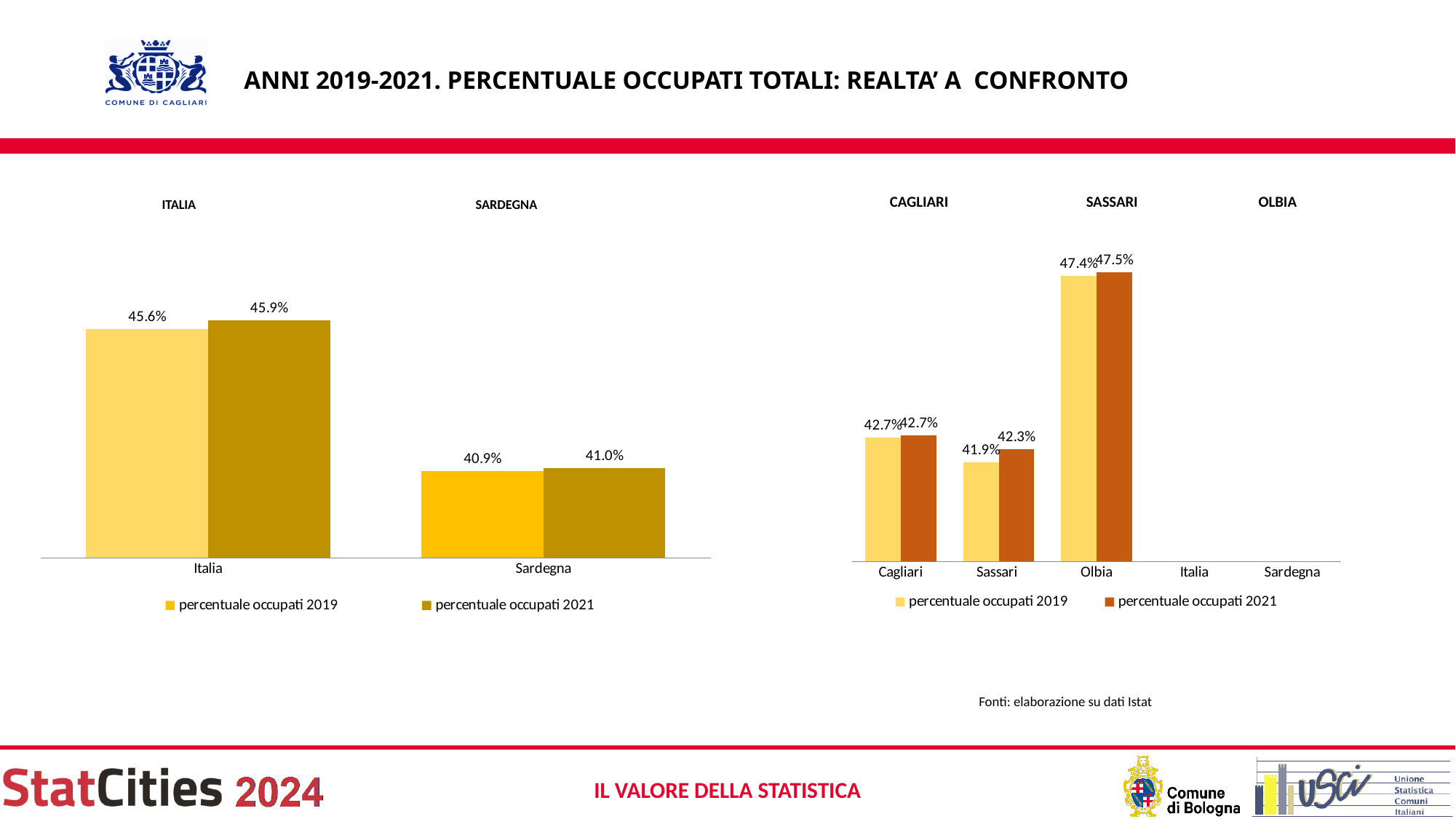
In the right chart, what is the difference between the percentuale occupati 2019 and 2021 for Sassari? 0.4% In the left chart, what is the difference between the percentuale occupati 2021 for Italia and for Sardegna? 4.9% In the right chart, which city has the highest percentuale occupati 2021? Olbia How many series does the legend of the left chart list? 2 In the right chart, what is the percentuale occupati 2021 for Sassari? 42.3% In the left chart, which is larger: the percentuale occupati 2019 for Italia or for Sardegna? Italia In the right chart, what is the percentuale occupati 2019 for Olbia? 47.4% In the left chart, what is the percentuale occupati 2021 for Sardegna? 41.0% How many categories have bars in the left chart? 2 What type of chart is the right chart? Bar chart In the left chart, what is the percentuale occupati 2019 for Italia? 45.6% In the right chart, which city has the lowest percentuale occupati 2019? Sassari